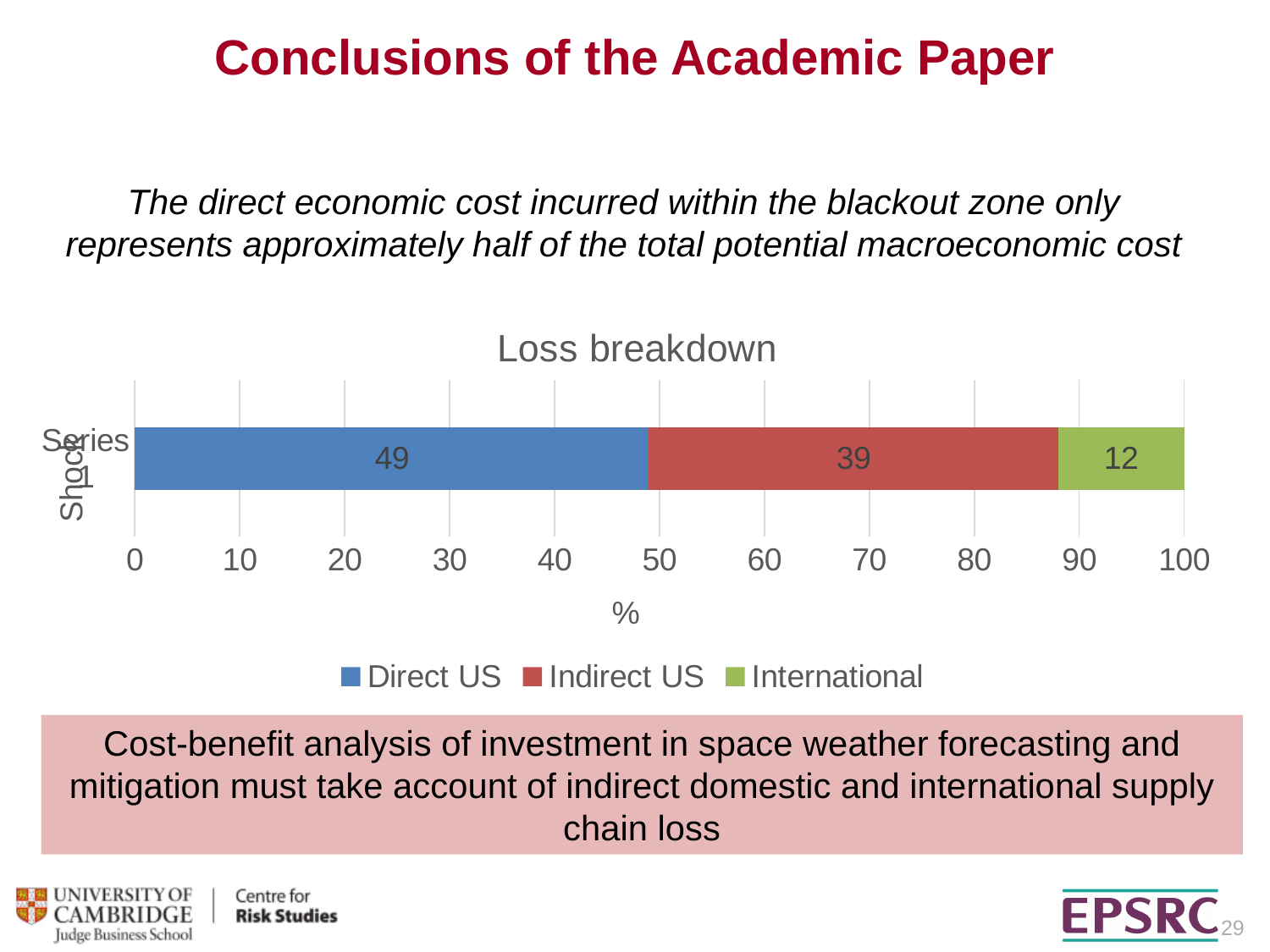
What is the difference between the Indirect US and International values? 27 What is the value for Indirect US in the Loss breakdown chart? 39 Which is larger, Direct US or International? Direct US What is the value for Direct US in the Loss breakdown chart? 49 What is the difference between the Direct US and Indirect US values? 10 What is the value for International in the Loss breakdown chart? 12 Which series has the smallest value in the Loss breakdown chart? International What is the title of the chart? Loss breakdown Which series has the largest value in the Loss breakdown chart? Direct US What is the total of the stacked bar in the Loss breakdown chart? 100 How many series does the legend list? 3 What kind of chart is shown on the slide? Stacked bar chart